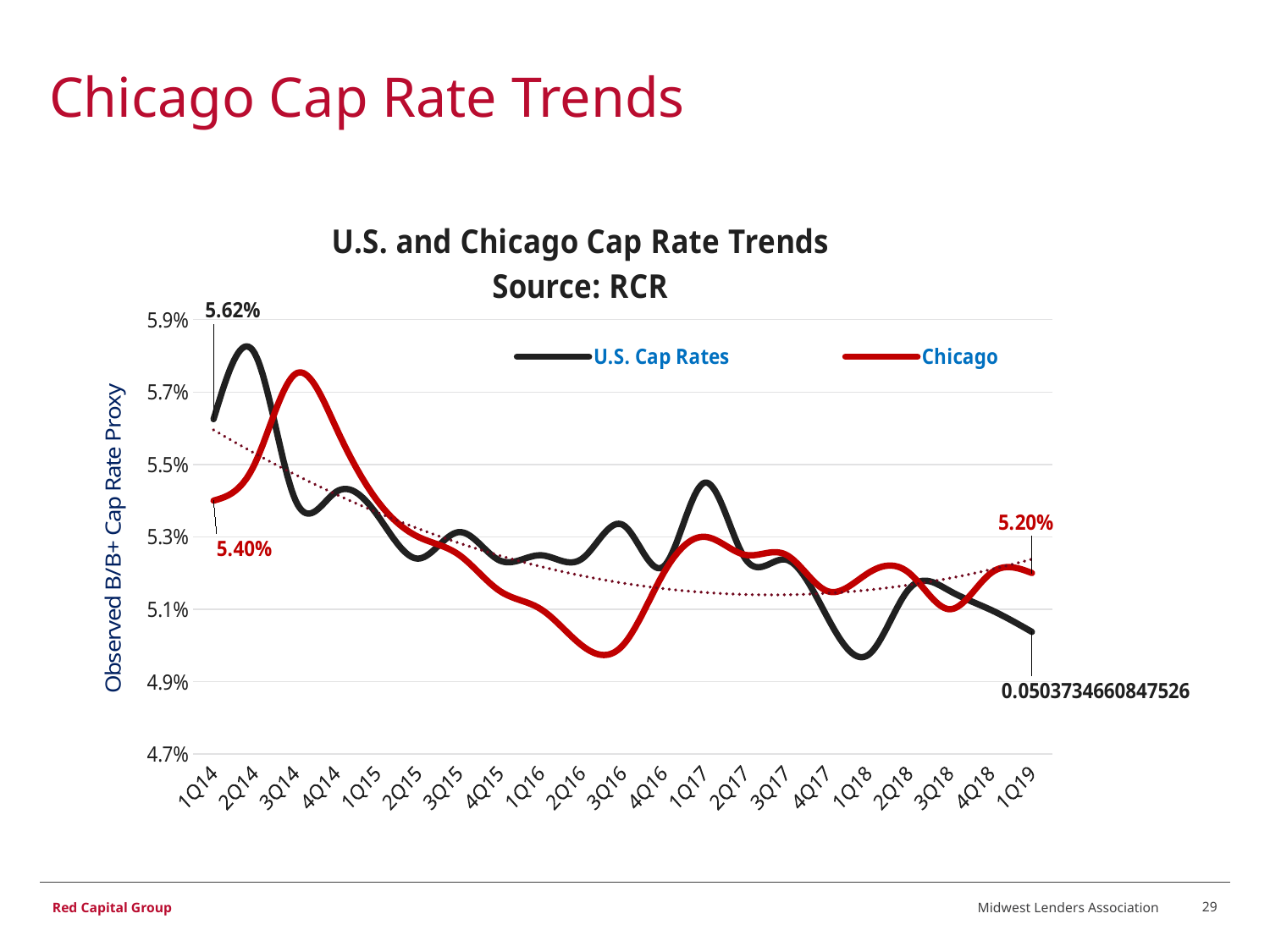
What is the Chicago value labelled at 1Q14? 5.40% What is the U.S. Cap Rates value labelled at 1Q14? 5.62% At 1Q19, which series has the higher labelled value, U.S. Cap Rates or Chicago? Chicago How many series does the chart legend list? 2 At 1Q14, which series has the higher labelled value, U.S. Cap Rates or Chicago? U.S. Cap Rates What is the difference between the U.S. Cap Rates and Chicago values labelled at 1Q14? 0.22% What kind of chart is shown on the slide? Line chart What is the Chicago value labelled at 1Q19? 5.20% What is the U.S. Cap Rates value labelled at 1Q19? 0.0503734660847526 Do the cap rate values generally rise or fall from 1Q14 to 1Q19? Fall How many quarters are shown on the x axis? 21 Is the Chicago value at 3Q16 greater or less than 5.1%? less